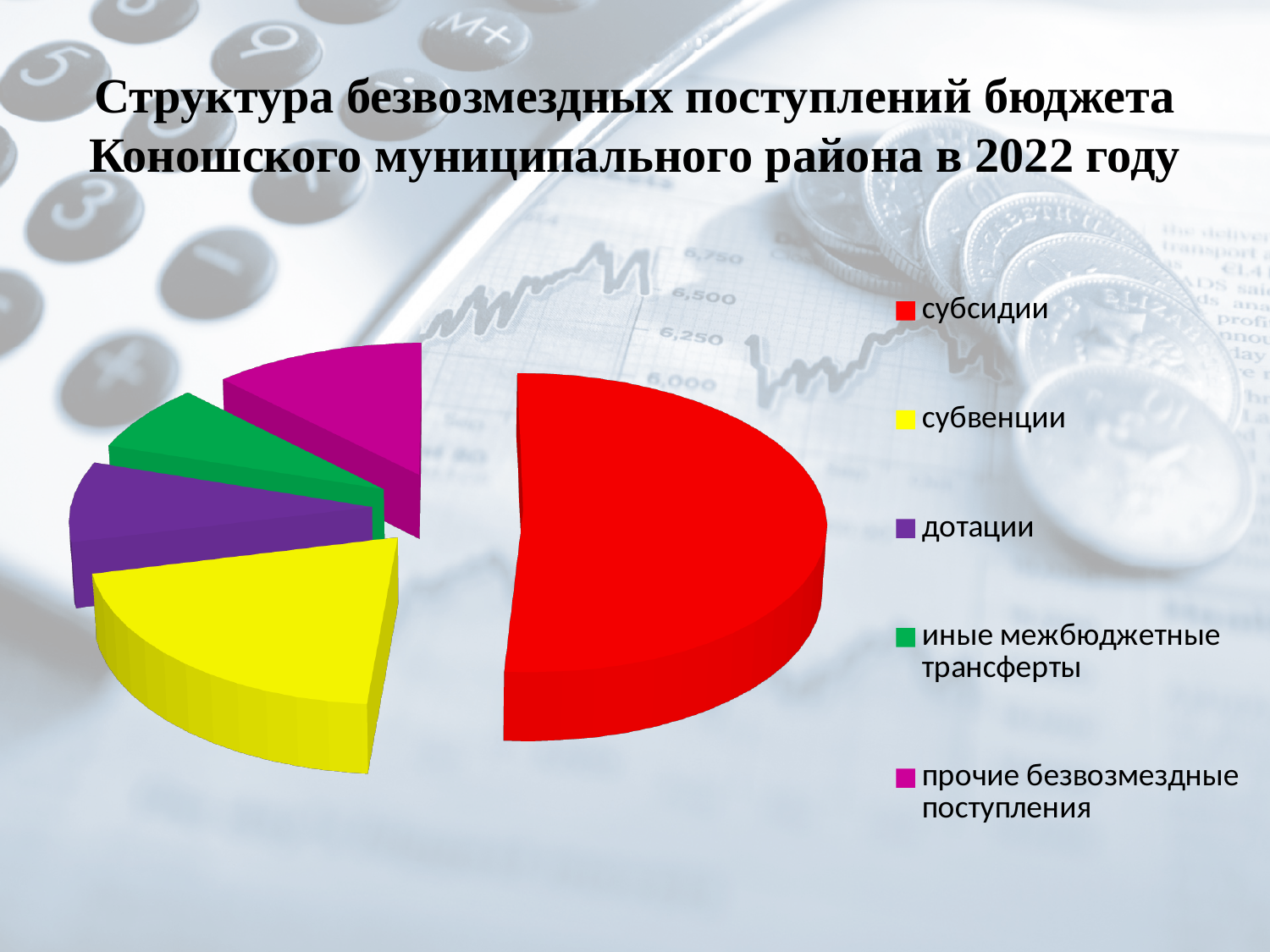
Which is larger: the slice for субсидии or the slice for субвенции? субсидии Which category has the largest share of the pie? субсидии Which is larger: the slice for субвенции or the slice for дотации? субвенции Which is larger: the slice for субсидии or the slice for прочие безвозмездные поступления? субсидии How many entries does the legend list? 5 How many slices does the pie chart have? 5 What colour is the slice for субсидии? red What is the title of the chart on the slide? Структура безвозмездных поступлений бюджета Коношского муниципального района в 2022 году What kind of chart is shown on the slide? pie chart